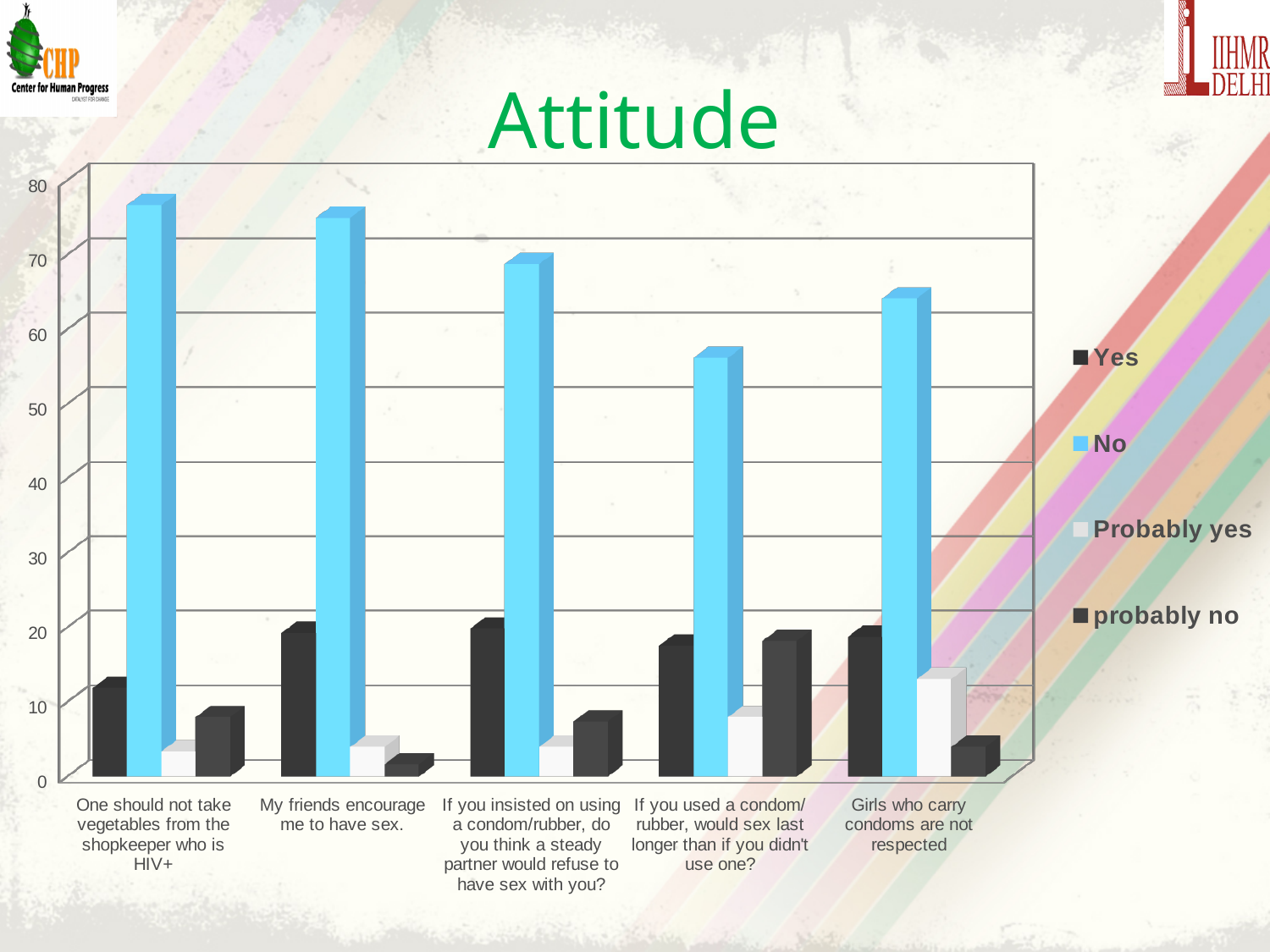
Is the 'No' value for 'My friends encourage me to have sex.' greater or less than 70? greater How many series does the legend list? 4 Is the 'No' value for 'Girls who carry condoms are not respected' greater or less than 60? greater For 'Girls who carry condoms are not respected', which is larger: the 'Probably yes' value or the 'probably no' value? Probably yes Is the 'Yes' value for 'One should not take vegetables from the shopkeeper who is HIV+' greater or less than 20? less For which statement is the 'No' bar the highest? One should not take vegetables from the shopkeeper who is HIV+ Which series is shown in light blue in the legend? No What kind of chart is shown on the slide? bar chart For 'If you used a condom/ rubber, would sex last longer than if you didn't use one?', which is larger: the 'No' value or the 'Yes' value? No How many statement categories are shown along the x axis? 5 For which statement is the 'No' bar the lowest? If you used a condom/ rubber, would sex last longer than if you didn't use one? What is the title of the chart? Attitude